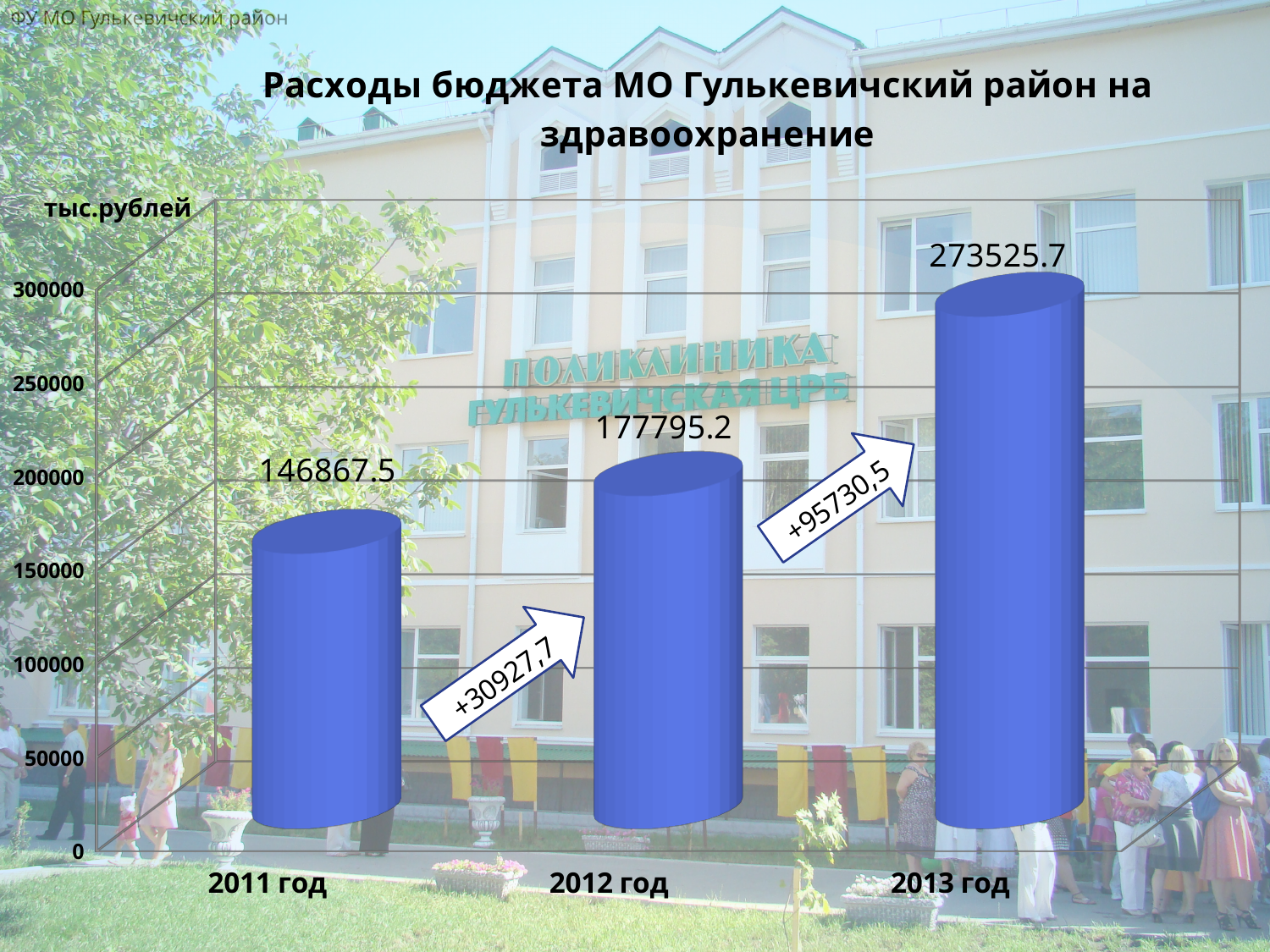
What is the value for 2011 год? 146867.5 How many years are shown on the chart? 3 What is the difference between the values for 2013 год and 2012 год? 95730.5 Which is larger, the value for 2012 год or the value for 2013 год? 2013 год What kind of chart is shown on the slide? bar chart What is the value for 2012 год? 177795.2 Which year has the highest value? 2013 год Is the value for 2013 год greater or less than 250000? greater Do the values rise or fall from 2011 год to 2013 год? rise Which year has the lowest value? 2011 год What is the value for 2013 год? 273525.7 What is the difference between the values for 2012 год and 2011 год? 30927.7